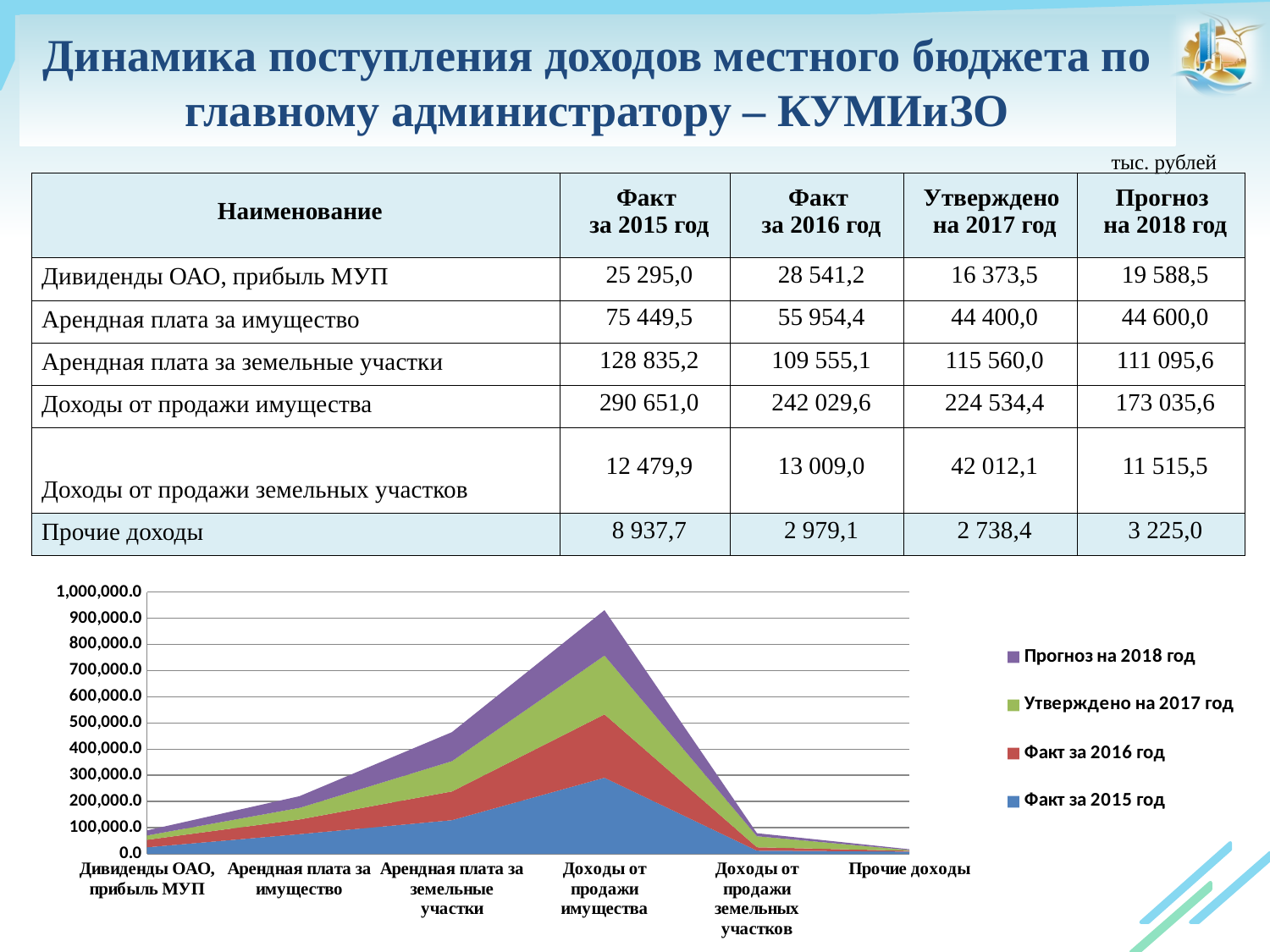
What is the value of Факт за 2015 год for Доходы от продажи имущества? 290 651,0 Which category has the highest stacked value in the chart? Доходы от продажи имущества What kind of chart is shown at the bottom of the slide? stacked area chart What is the difference between Факт за 2016 год and Факт за 2015 год for Дивиденды ОАО, прибыль МУП? 3 246,2 Is the stacked total for Доходы от продажи имущества greater or less than 900,000.0? greater Which category has the lowest stacked value in the chart? Прочие доходы How many series does the chart legend list? 4 Which is larger for Арендная плата за имущество: Факт за 2015 год or Факт за 2016 год? Факт за 2015 год How many categories are shown along the x axis of the chart? 6 What is the value of Прогноз на 2018 год for Арендная плата за земельные участки? 111 095,6 Which series is shown in purple in the chart legend? Прогноз на 2018 год What is the value of Утверждено на 2017 год for Доходы от продажи земельных участков? 42 012,1